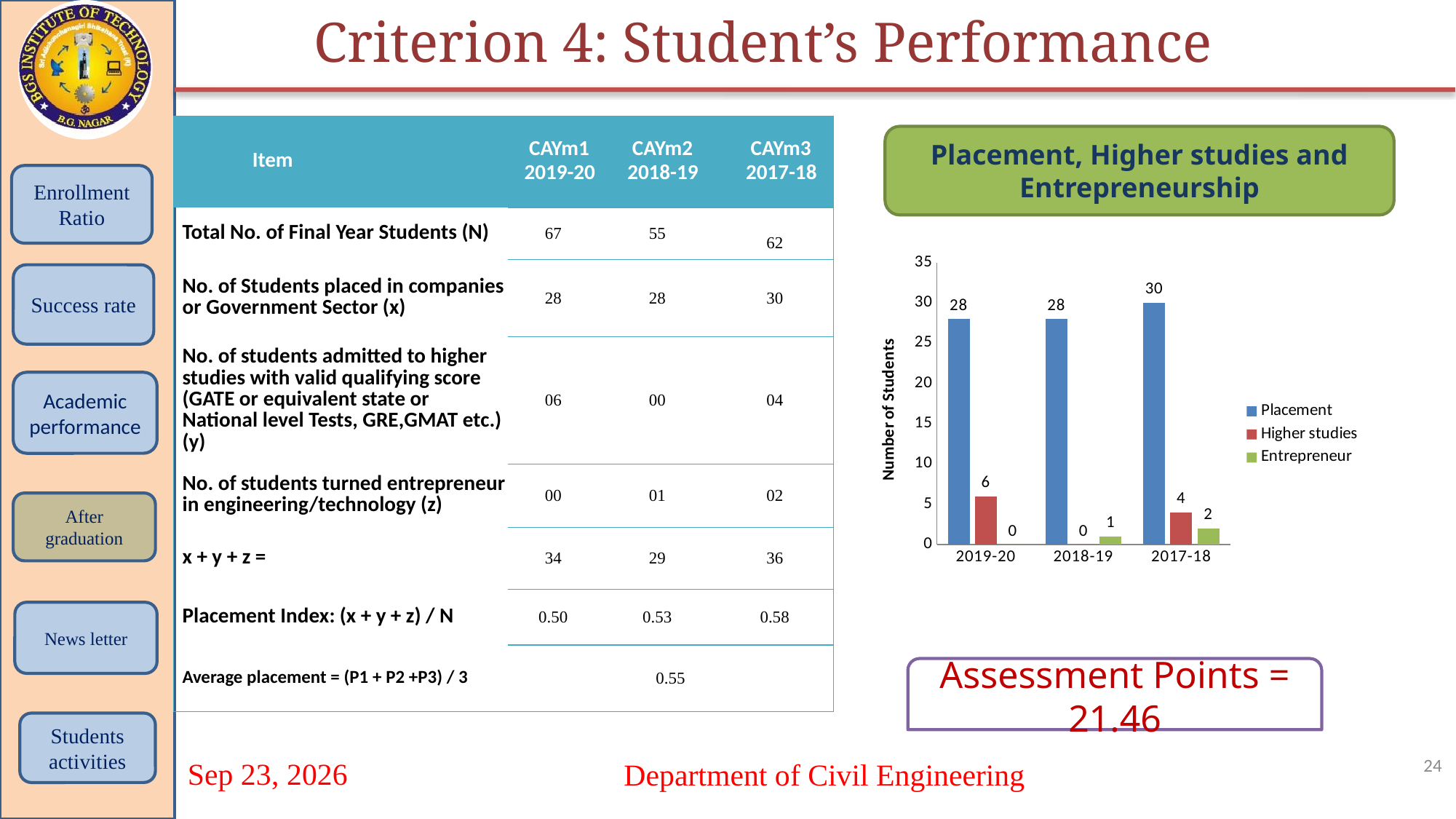
How many years are shown on the x axis? 3 What kind of chart is shown on the slide? bar chart What is the Entrepreneur value for 2018-19? 1 What is the difference between the Placement value for 2017-18 and the Placement value for 2019-20? 2 What is the Higher studies value for 2019-20? 6 What is the Placement value for 2017-18? 30 How many series does the legend list? 3 Which year has the lowest Higher studies value? 2018-19 Which year has the highest Placement value? 2017-18 Is the Placement value for 2018-19 greater or less than 25? greater Which is larger: the Higher studies value for 2019-20 or the Higher studies value for 2017-18? 2019-20 What is the title of the chart? Placement, Higher studies and Entrepreneurship